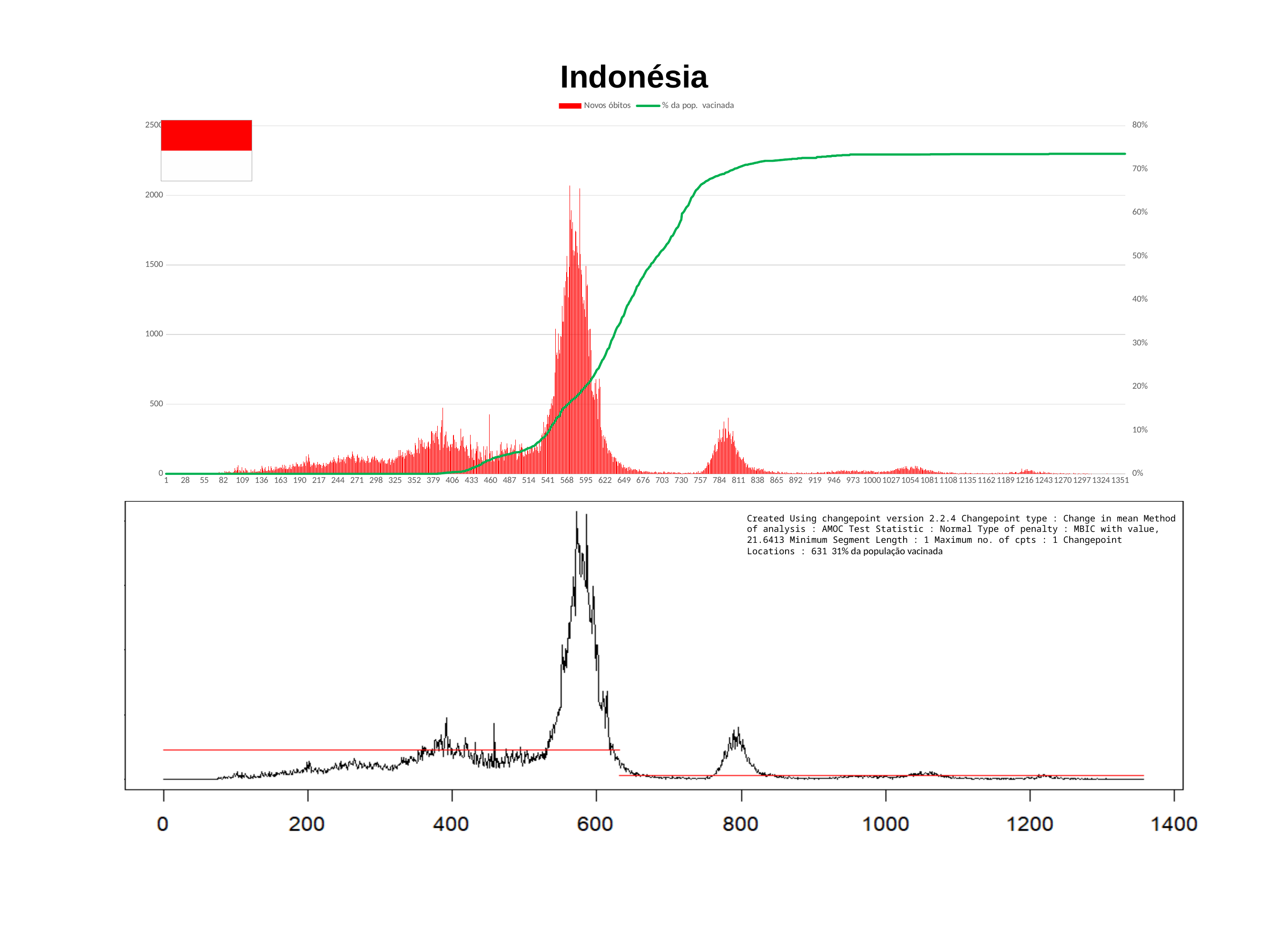
How many series does the legend of the top chart list? 2 In the top chart, is the 'Novos óbitos' peak around day 784 greater or less than 500? less In the top chart, is the 'Novos óbitos' peak around day 784 higher or lower than the peak around day 568? lower In the top chart, is the highest 'Novos óbitos' bar greater or less than 1500? greater In the top chart, which series is drawn as red bars? Novos óbitos What kind of chart is the bottom chart? line chart According to the text in the bottom chart, at what location is the changepoint? 631 In the top chart, is the value of '% da pop. vacinada' at day 433 greater or less than 10%? less What is the maximum value shown on the right-hand axis of the top chart? 80% What is the title of the top chart? Indonésia In the top chart, does the green '% da pop. vacinada' line rise or fall along the x axis? rise